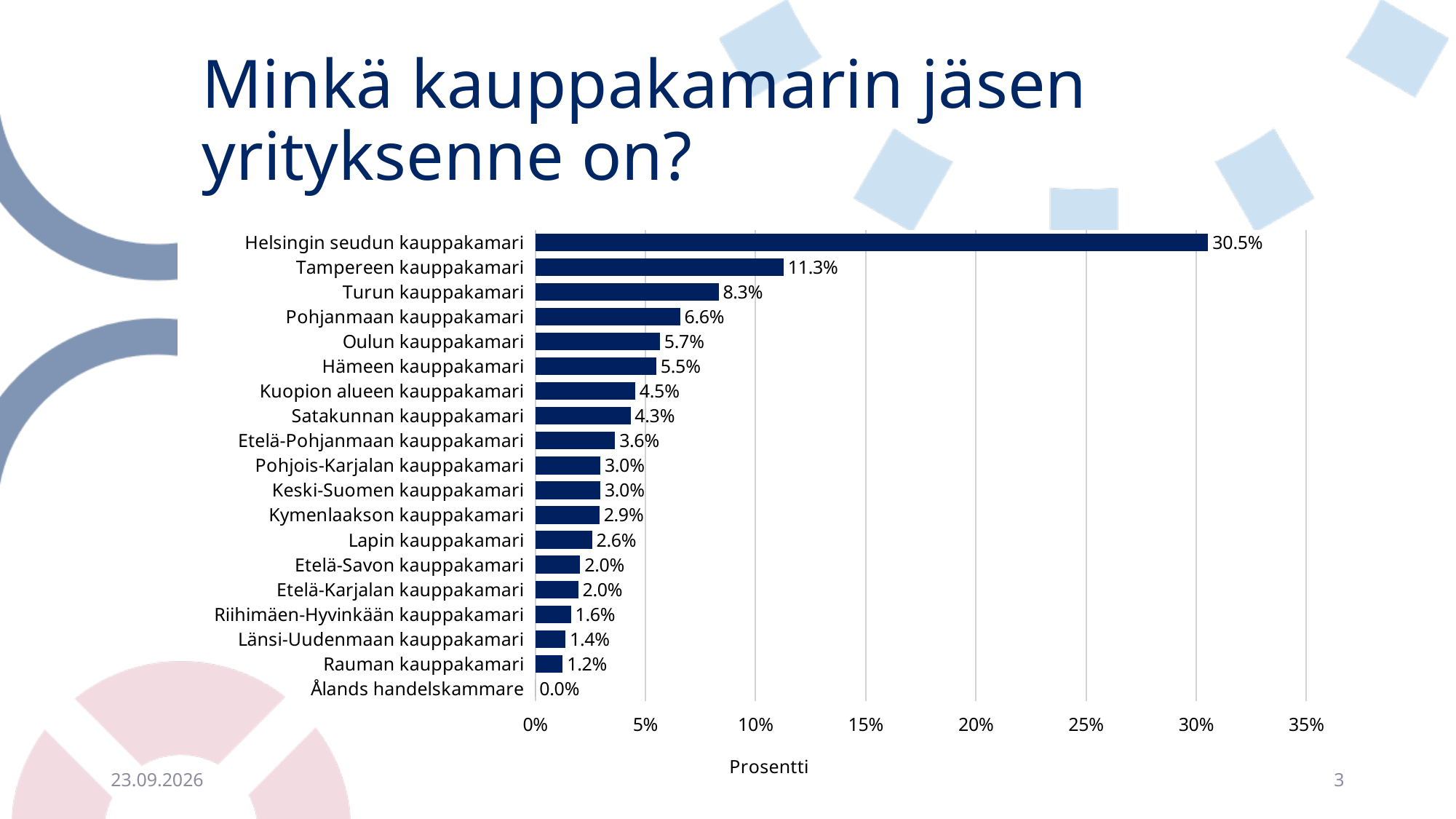
What is the value for Turun kauppakamari? 8.3% Which chamber of commerce has the highest share? Helsingin seudun kauppakamari What is the value for Riihimäen-Hyvinkään kauppakamari? 1.6% How many categories are shown in the chart? 19 Which is larger, Oulun kauppakamari or Pohjanmaan kauppakamari? Pohjanmaan kauppakamari What is the value for Kuopion alueen kauppakamari? 4.5% What kind of chart is shown on the slide? bar chart What is the difference between Tampereen kauppakamari and Turun kauppakamari? 3.0% Which category has the lowest value? Ålands handelskammare What is the value for Helsingin seudun kauppakamari? 30.5% What is the label of the horizontal axis? Prosentti What is the difference between Helsingin seudun kauppakamari and Tampereen kauppakamari? 19.2%